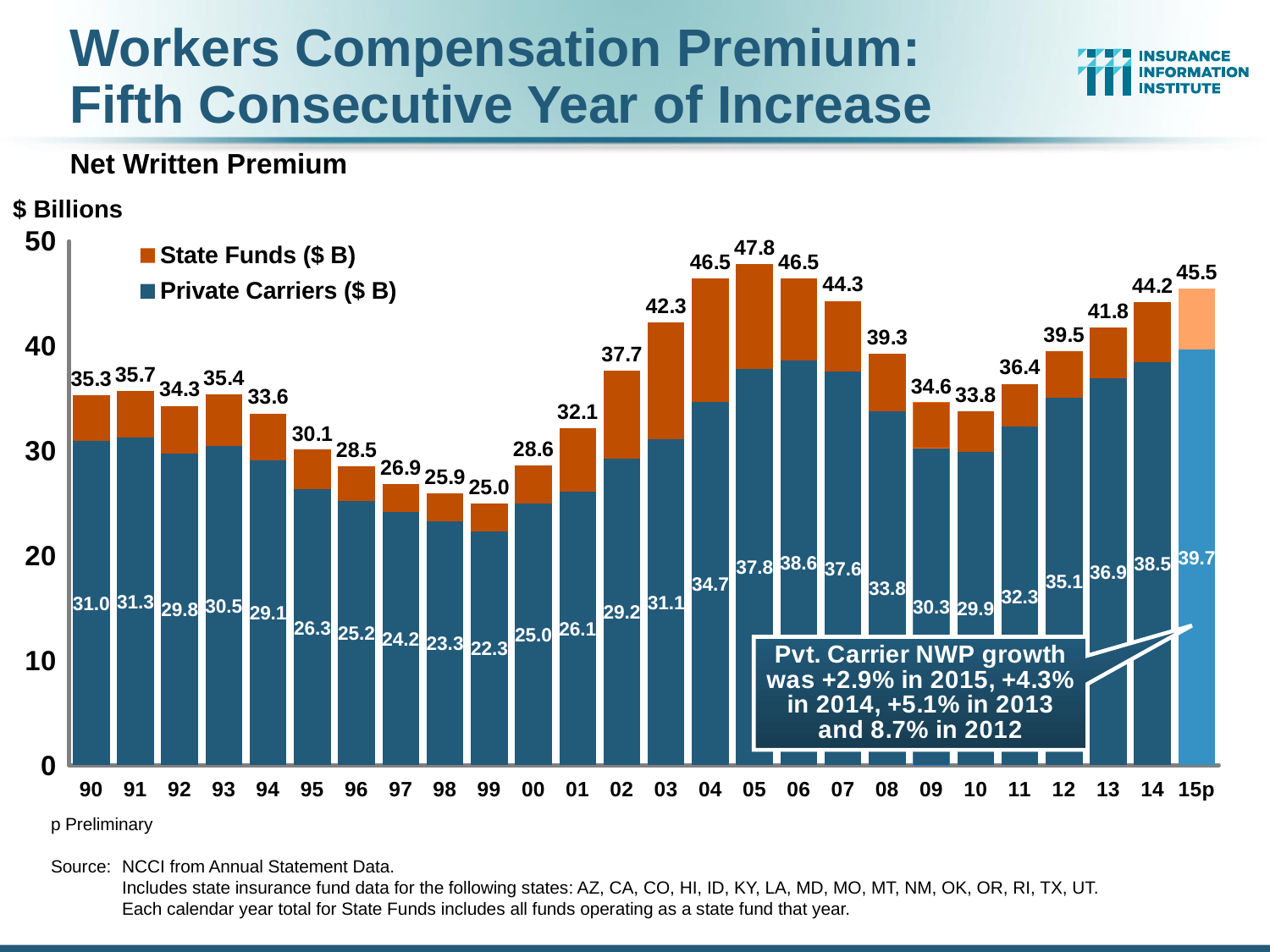
How many series does the legend list? 2 What is the unit shown on the y axis? $ Billions How many years are shown on the x axis? 26 What type of chart is shown on the slide? Stacked bar chart Which year has the highest total net written premium? 05 What was the Private Carriers net written premium in 2005? 37.8 Which year has the highest Private Carriers value? 15p Which is larger, the total net written premium in 2004 or in 2006? They are equal (46.5) Is the total net written premium for 2003 greater or less than 40? greater Which year has the lowest total net written premium? 99 What was the total net written premium (top-of-bar label) for 2015p? 45.5 What is the difference between the total net written premium in 2014 and in 2013? 2.4